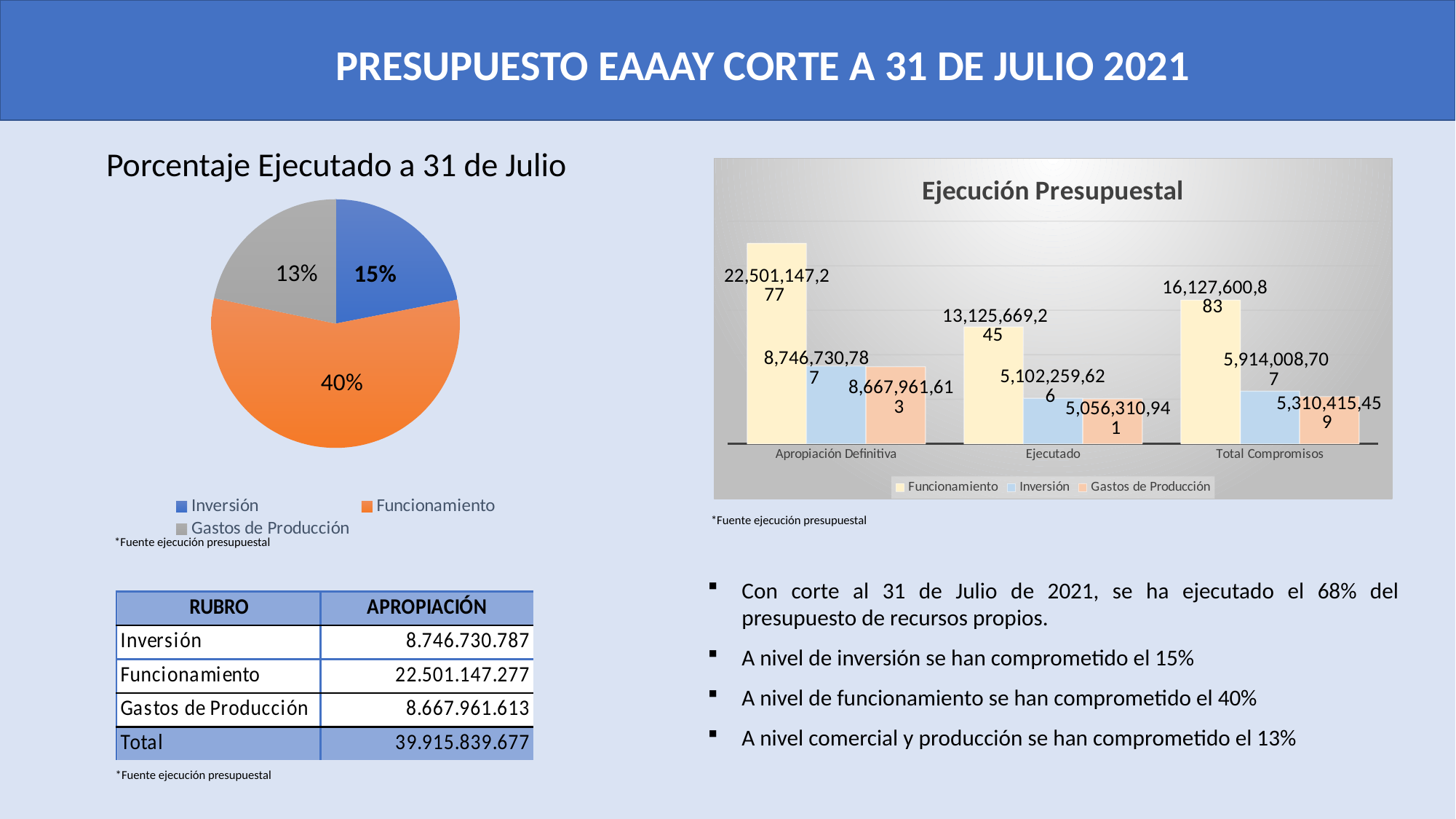
In the bar chart 'Ejecución Presupuestal', what is the value of Gastos de Producción for Total Compromisos? 5,310,415,459 In the bar chart 'Ejecución Presupuestal', what is the value of Funcionamiento for Apropiación Definitiva? 22,501,147,277 In the bar chart 'Ejecución Presupuestal', which series has the highest value in the Ejecutado category? Funcionamiento In the pie chart 'Porcentaje Ejecutado a 31 de Julio', which category has the smallest slice? Gastos de Producción In the pie chart 'Porcentaje Ejecutado a 31 de Julio', what percentage is shown for Funcionamiento? 40% How many categories does the legend of the pie chart 'Porcentaje Ejecutado a 31 de Julio' list? 3 How many series does the legend of the bar chart 'Ejecución Presupuestal' list? 3 In the bar chart 'Ejecución Presupuestal', what is the value of Inversión for Ejecutado? 5,102,259,626 What type of chart is 'Ejecución Presupuestal'? Bar chart In the pie chart 'Porcentaje Ejecutado a 31 de Julio', what is the difference in percentage points between Funcionamiento and Inversión? 25 In the pie chart 'Porcentaje Ejecutado a 31 de Julio', what percentage is shown for Gastos de Producción? 13% In the pie chart 'Porcentaje Ejecutado a 31 de Julio', which category has the largest slice? Funcionamiento